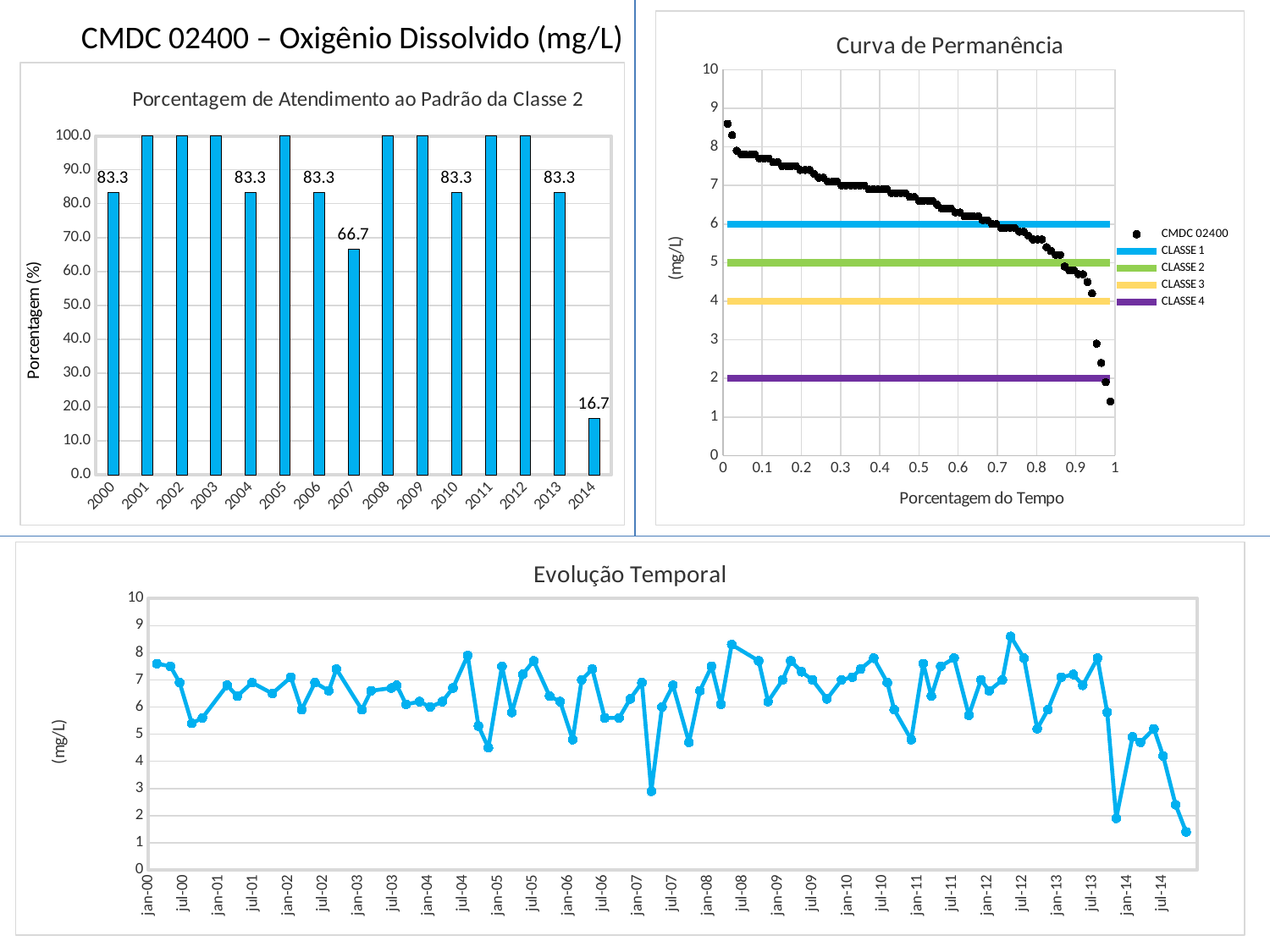
In the 'Evolução Temporal' chart, is the lowest plotted value greater or less than 2? less In the bar chart 'Porcentagem de Atendimento ao Padrão da Classe 2', what is the difference between the values for 2000 and 2007? 16.6 How many years are shown on the x axis of the bar chart 'Porcentagem de Atendimento ao Padrão da Classe 2'? 15 In the bar chart 'Porcentagem de Atendimento ao Padrão da Classe 2', what is the value for 2007? 66.7 In the bar chart 'Porcentagem de Atendimento ao Padrão da Classe 2', which year has the lowest value? 2014 In the bar chart 'Porcentagem de Atendimento ao Padrão da Classe 2', what is the value for 2014? 16.7 In the 'Curva de Permanência' chart, is the CMDC 02400 value at 0.5 on the x axis greater or less than 6? greater What kind of chart is 'Porcentagem de Atendimento ao Padrão da Classe 2'? Bar chart What is the x-axis title of the 'Curva de Permanência' chart? Porcentagem do Tempo In the bar chart 'Porcentagem de Atendimento ao Padrão da Classe 2', which year has the larger value, 2004 or 2014? 2004 What kind of chart is 'Evolução Temporal'? Line chart How many entries does the legend of the 'Curva de Permanência' chart list? 5